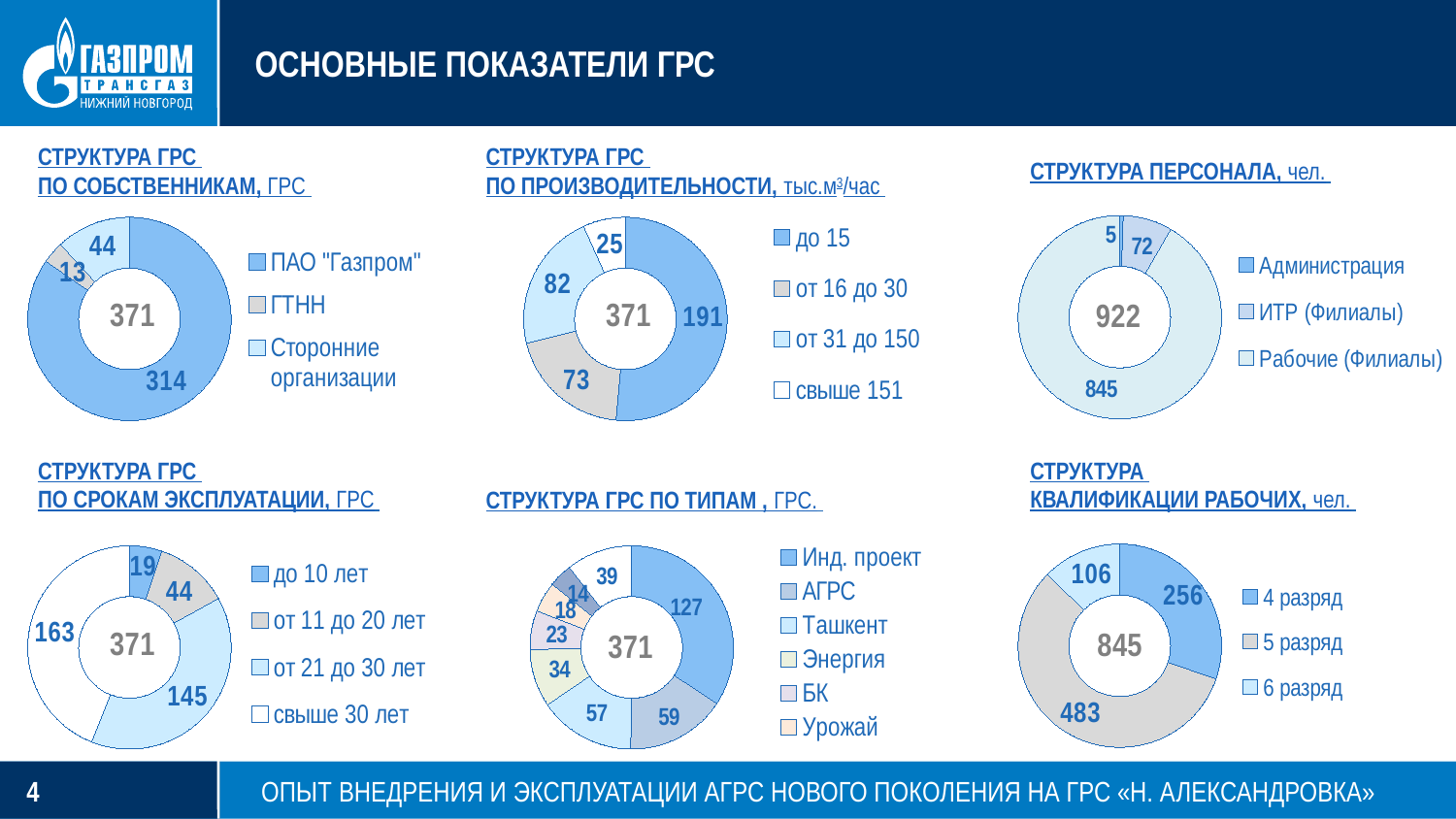
On the 'СТРУКТУРА ГРС ПО ТИПАМ' chart, what is the value for 'Инд. проект'? 127 On the 'СТРУКТУРА ПЕРСОНАЛА' chart, what is the value for 'Рабочие (Филиалы)'? 845 On the 'СТРУКТУРА ПЕРСОНАЛА' chart, how many categories does the legend list? 3 On the 'СТРУКТУРА ГРС ПО СОБСТВЕННИКАМ' chart, what total is shown in the centre of the donut? 371 On the 'СТРУКТУРА ГРС ПО СОБСТВЕННИКАМ' chart, what is the value for ПАО "Газпром"? 314 On the 'СТРУКТУРА ГРС ПО СРОКАМ ЭКСПЛУАТАЦИИ' chart, which is larger: 'от 11 до 20 лет' or 'от 21 до 30 лет'? от 21 до 30 лет What kind of chart is used for 'СТРУКТУРА КВАЛИФИКАЦИИ РАБОЧИХ'? Donut (pie) chart On the 'СТРУКТУРА ГРС ПО ПРОИЗВОДИТЕЛЬНОСТИ' chart, which category has the lowest value? свыше 151 On the 'СТРУКТУРА ГРС ПО СРОКАМ ЭКСПЛУАТАЦИИ' chart, which category has the highest value? свыше 30 лет On the 'СТРУКТУРА КВАЛИФИКАЦИИ РАБОЧИХ' chart, what is the value for '5 разряд'? 483 On the 'СТРУКТУРА ГРС ПО ПРОИЗВОДИТЕЛЬНОСТИ' chart, what is the difference between 'от 31 до 150' and 'от 16 до 30'? 9 On the 'СТРУКТУРА ГРС ПО ПРОИЗВОДИТЕЛЬНОСТИ' chart, what is the value for 'до 15'? 191